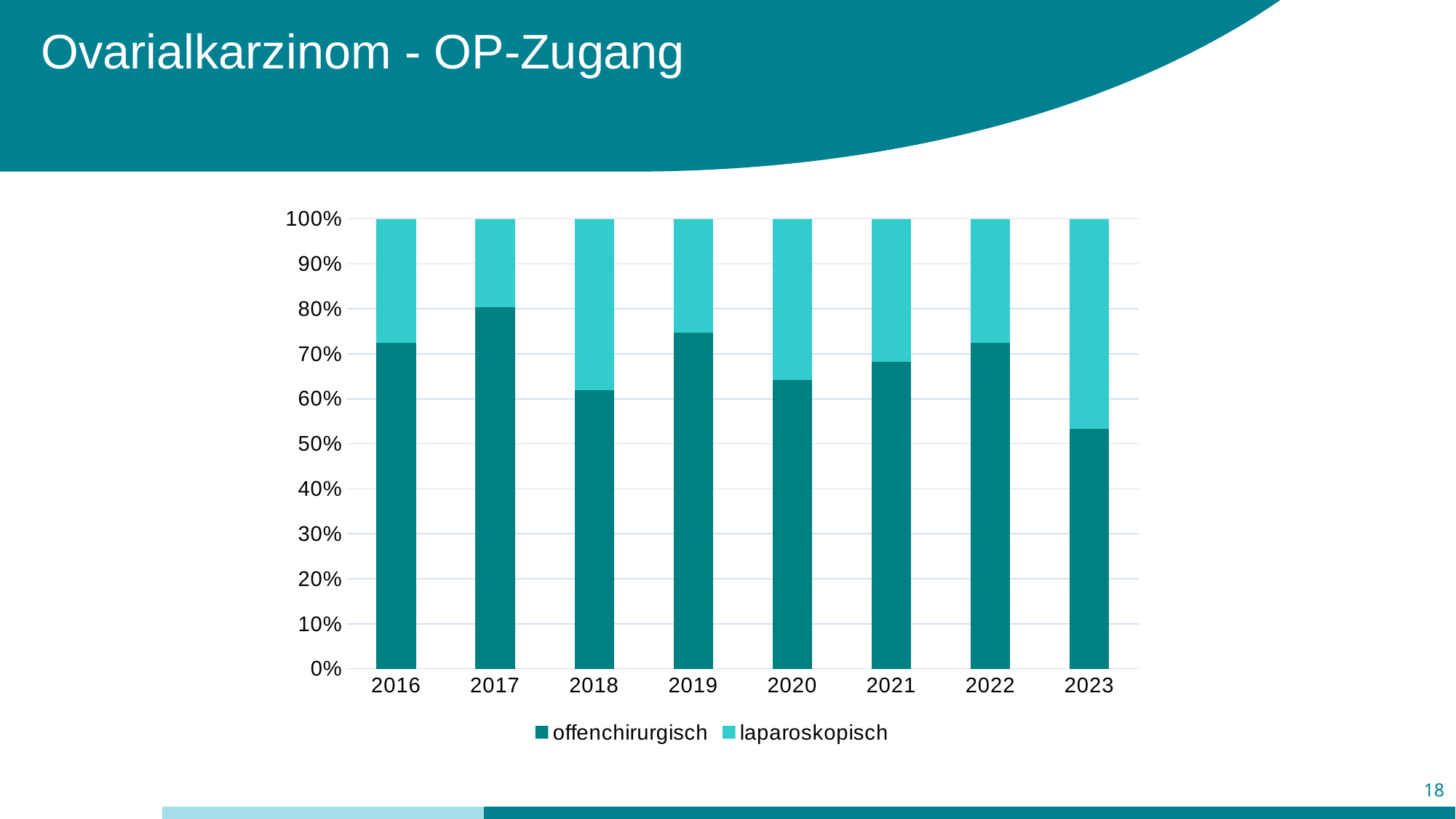
How many series does the legend list? 2 What is the title of the slide containing the chart? Ovarialkarzinom - OP-Zugang What kind of chart is shown on the slide? stacked bar chart Is the share of offenchirurgisch in 2017 greater or less than 70%? greater Which year has the highest share of laparoskopisch? 2023 Is the share of offenchirurgisch in 2018 greater or less than 70%? less Which year has a larger share of offenchirurgisch, 2017 or 2018? 2017 What is the total of the stacked bar for 2016? 100% Which year has the lowest share of offenchirurgisch? 2023 Is the share of offenchirurgisch in 2023 greater or less than 60%? less Which year has the highest share of offenchirurgisch? 2017 How many years are shown on the x axis of the chart? 8